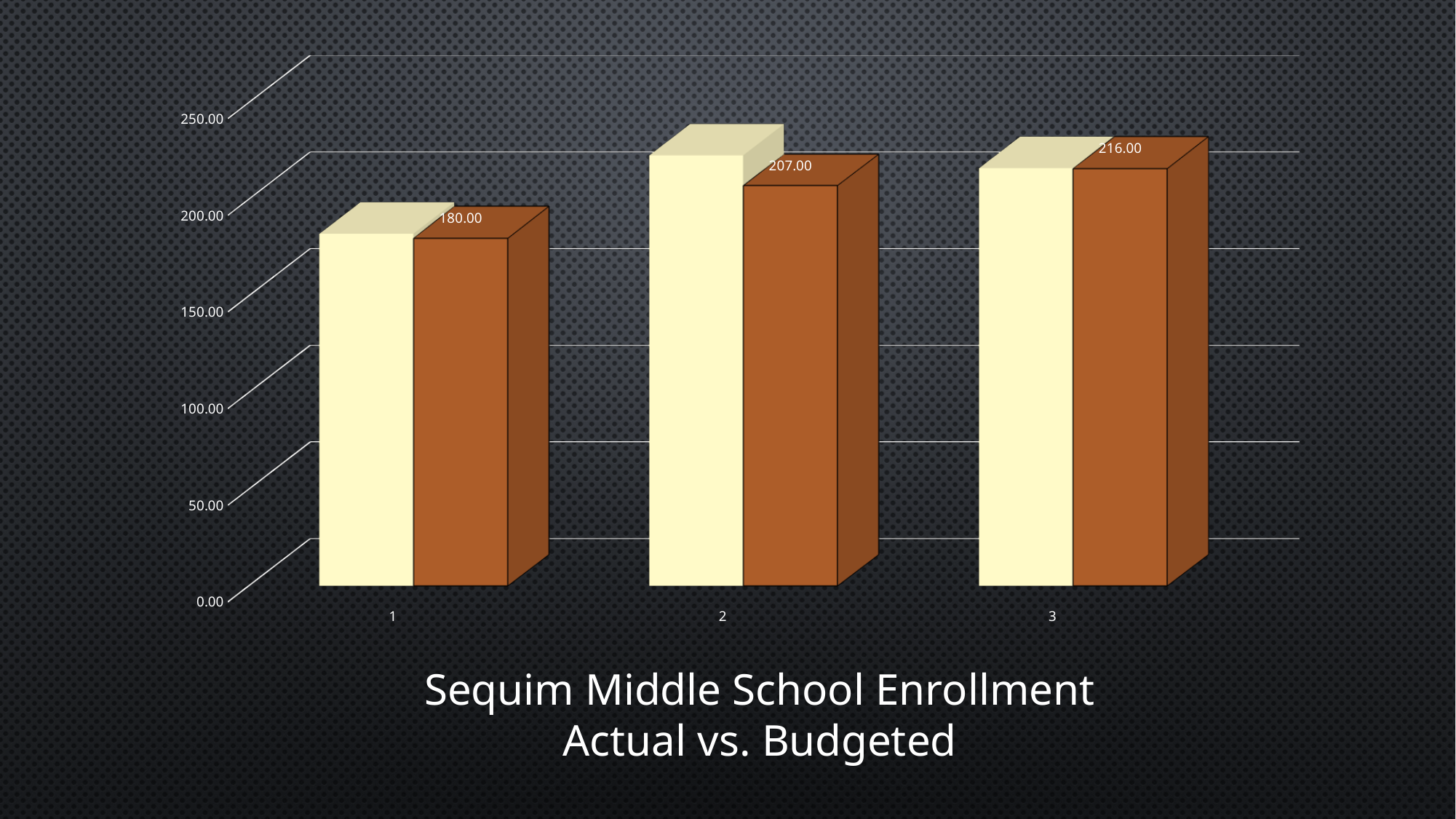
What is the value shown on the brown bar for category 1? 180.00 What is the value shown on the brown bar for category 3? 216.00 What is the difference between the brown bar values for category 2 and category 1? 27.00 What is the title of the chart? Sequim Middle School Enrollment Actual vs. Budgeted Which is larger, the brown bar value for category 2 or for category 3? Category 3 What is the value shown on the brown bar for category 2? 207.00 Among the brown bars, which category has the highest value? 3 How many categories are shown on the x axis? 3 Is the value of the cream bar for category 1 greater or less than 150.00? greater Among the brown bars, which category has the lowest value? 1 Do the brown bar values rise or fall from category 1 to category 3? rise What is the difference between the brown bar values for category 3 and category 1? 36.00